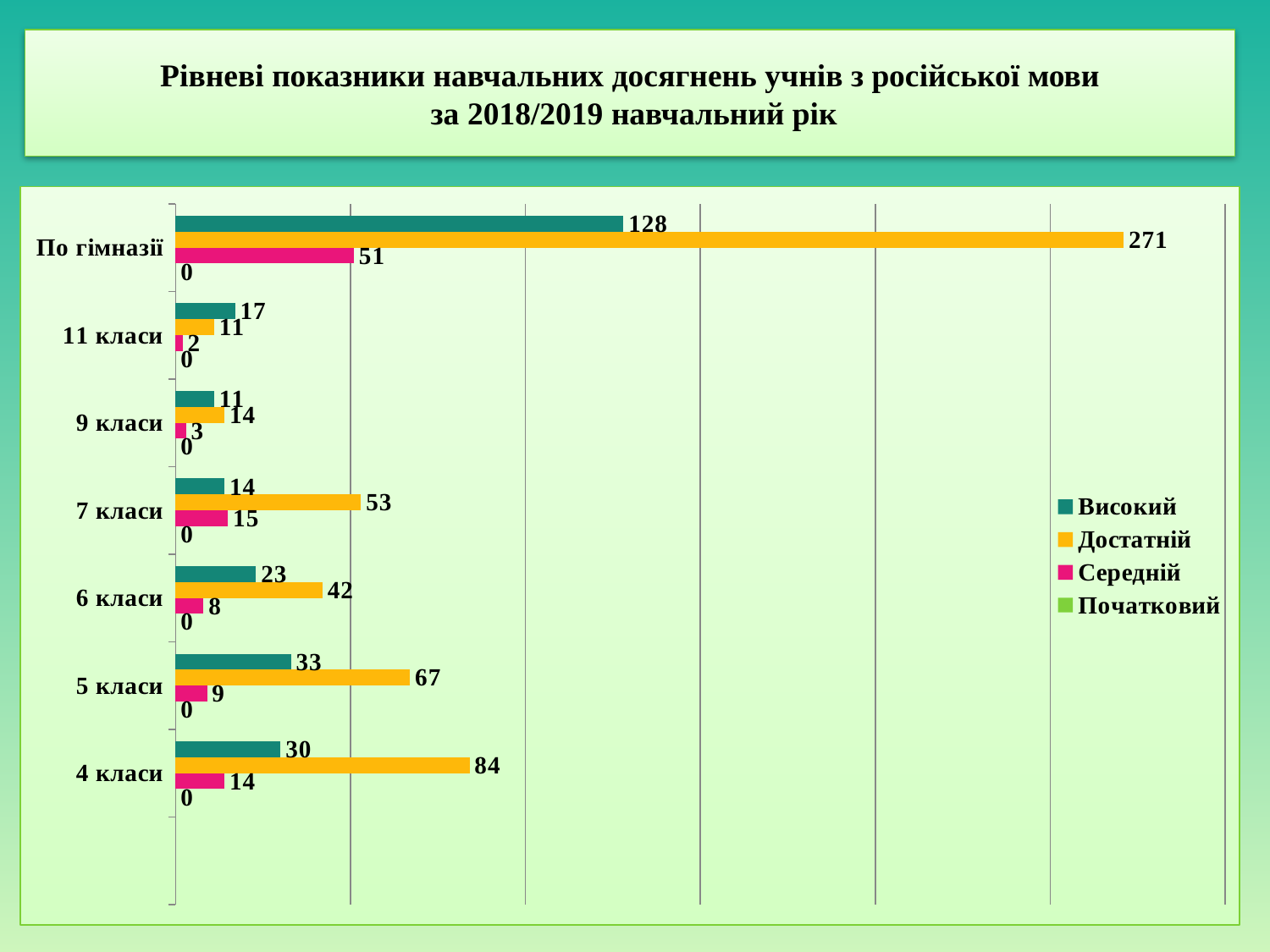
What kind of chart is shown on the slide? Bar chart What is the value of Початковий for 4 класи? 0 What is the value of Достатній for По гімназії? 271 Which class group has the lowest Середній value? 11 класи What is the value of Високий for 5 класи? 33 How many categories are shown on the vertical axis? 7 What is the difference between the Достатній and Високий values for По гімназії? 143 What is the value of Середній for 7 класи? 15 How many series does the legend list? 4 Which is larger for 9 класи: Високий or Достатній? Достатній Which legend entry is shown in orange? Достатній Which class group has the highest Достатній value, excluding По гімназії? 4 класи